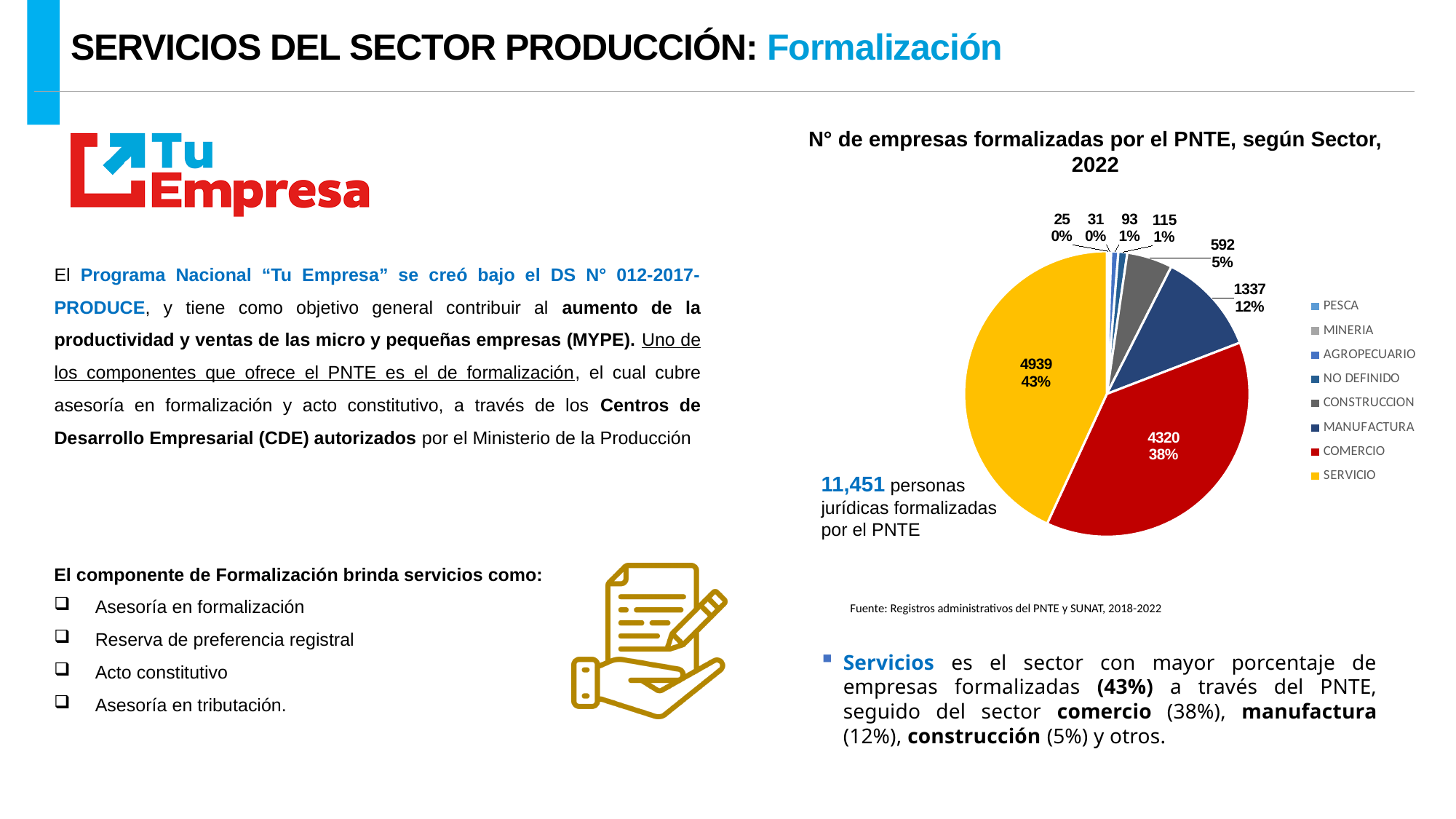
What is the title of the chart? N° de empresas formalizadas por el PNTE, según Sector, 2022 What kind of chart is shown on the slide? pie chart What share of the pie does the SERVICIO sector represent? 43% Which sector has the largest slice of the pie? SERVICIO What is the number of companies formalized in the SERVICIO sector? 4939 What is the value shown for the CONSTRUCCION sector? 592 What is the number of companies formalized in the COMERCIO sector? 4320 What is the difference between the SERVICIO and COMERCIO values? 619 Which is larger, the value for MANUFACTURA or the value for CONSTRUCCION? MANUFACTURA What share of the pie does the COMERCIO sector represent? 38% How many sectors does the chart legend list? 8 What is the value shown for the MANUFACTURA sector? 1337